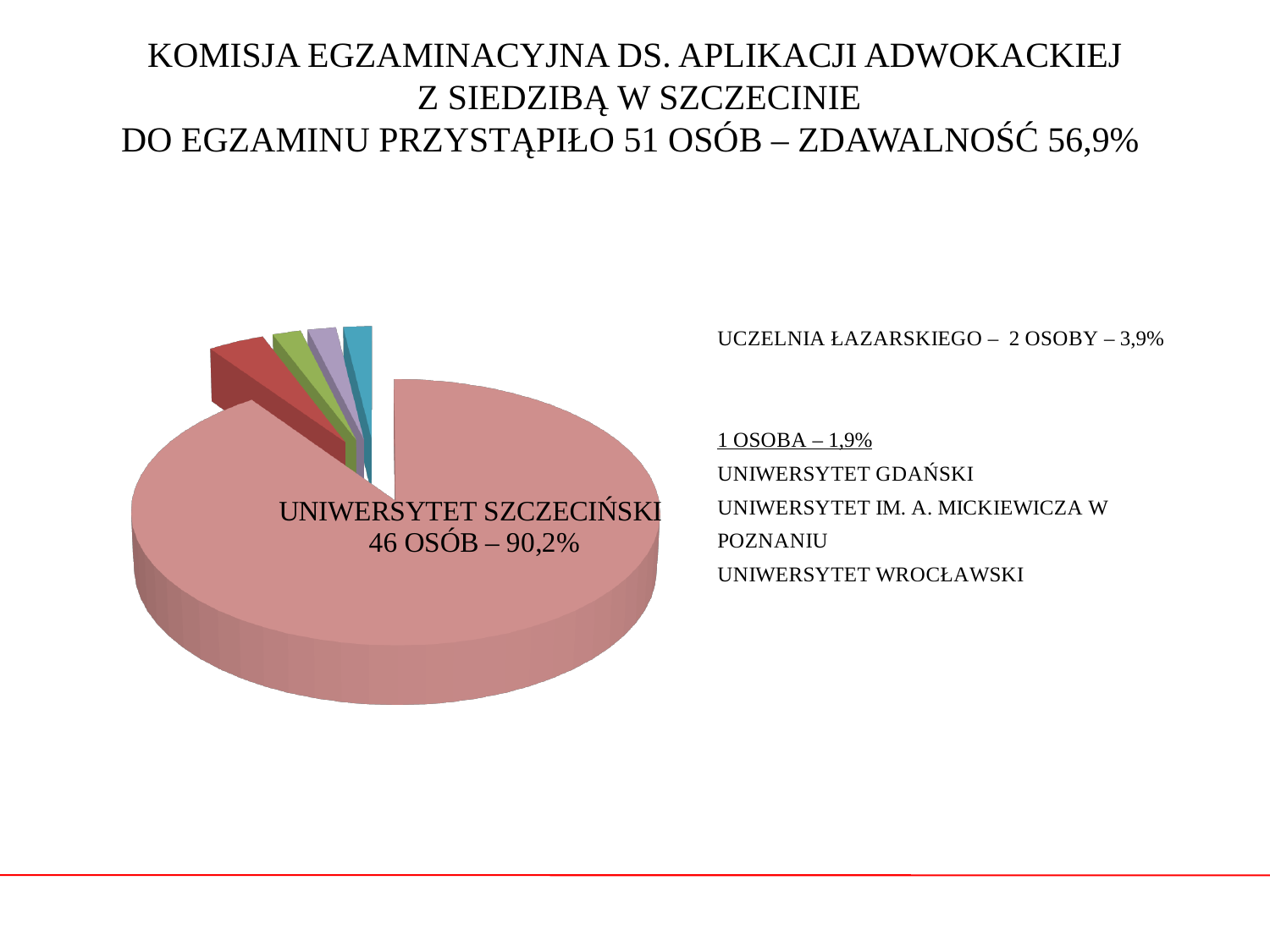
What is the total number of people represented across all slices of the pie? 51 According to the slide title, what was the pass rate (zdawalność) of the exam? 56,9% How many people from Uniwersytet Szczeciński are represented in the pie chart? 46 What percentage share is given for Uczelnia Łazarskiego? 3,9% What share of the pie does Uniwersytet Szczeciński account for? 90,2% How many more people are from Uniwersytet Szczeciński than from Uczelnia Łazarskiego? 44 How many people from Uczelnia Łazarskiego are represented in the pie chart? 2 Which university has the largest slice of the pie? Uniwersytet Szczeciński Which has more people, Uczelnia Łazarskiego or Uniwersytet Wrocławski? Uczelnia Łazarskiego What kind of chart is shown on the slide? pie chart What percentage share is given for Uniwersytet Gdański? 1,9% How many slices does the pie chart have? 5